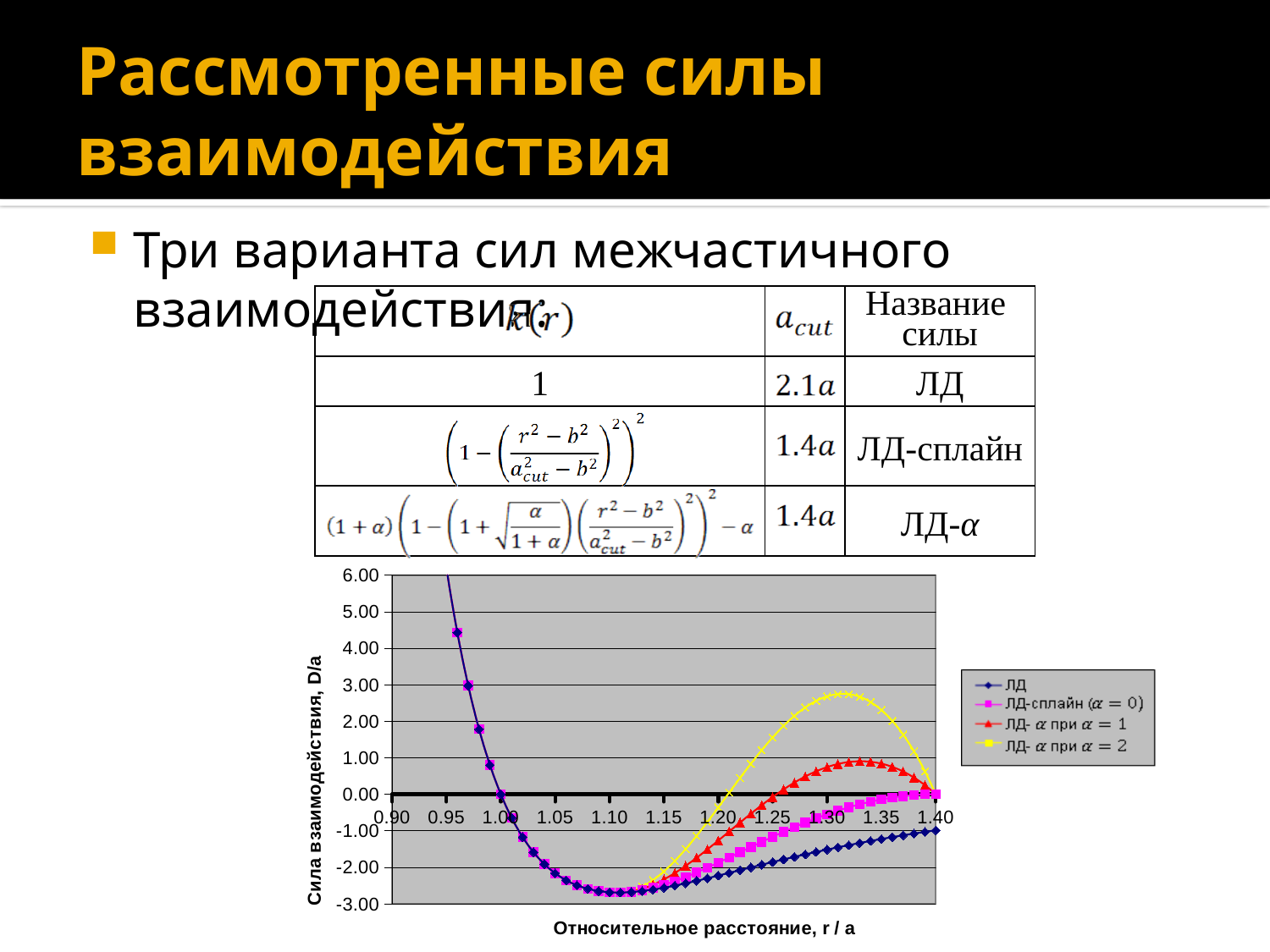
What kind of chart is shown on the slide? line chart How many series does the chart legend list? 4 At r/a = 1.25, which series has the larger value: ЛД-α при α = 2 or ЛД-сплайн (α = 0)? ЛД-α при α = 2 What are the series names listed in the chart legend? ЛД, ЛД-сплайн (α = 0), ЛД-α при α = 1, ЛД-α при α = 2 Do the values of the ЛД series rise or fall as r/a increases from 1.10 to 1.40? rise Which series reaches the highest peak in the right part of the chart (between r/a = 1.20 and 1.40)? ЛД-α при α = 2 Is the value of the ЛД-сплайн (α = 0) series at r/a = 1.20 greater or less than 0.00? less Is the value of the ЛД series at r/a = 1.40 greater or less than 0.00? less Which series has the lowest value at r/a = 1.40? ЛД What is the title of the chart's horizontal axis? Относительное расстояние, r / a Is the value of the ЛД-α при α = 2 series at r/a = 1.30 greater or less than 2.00? greater